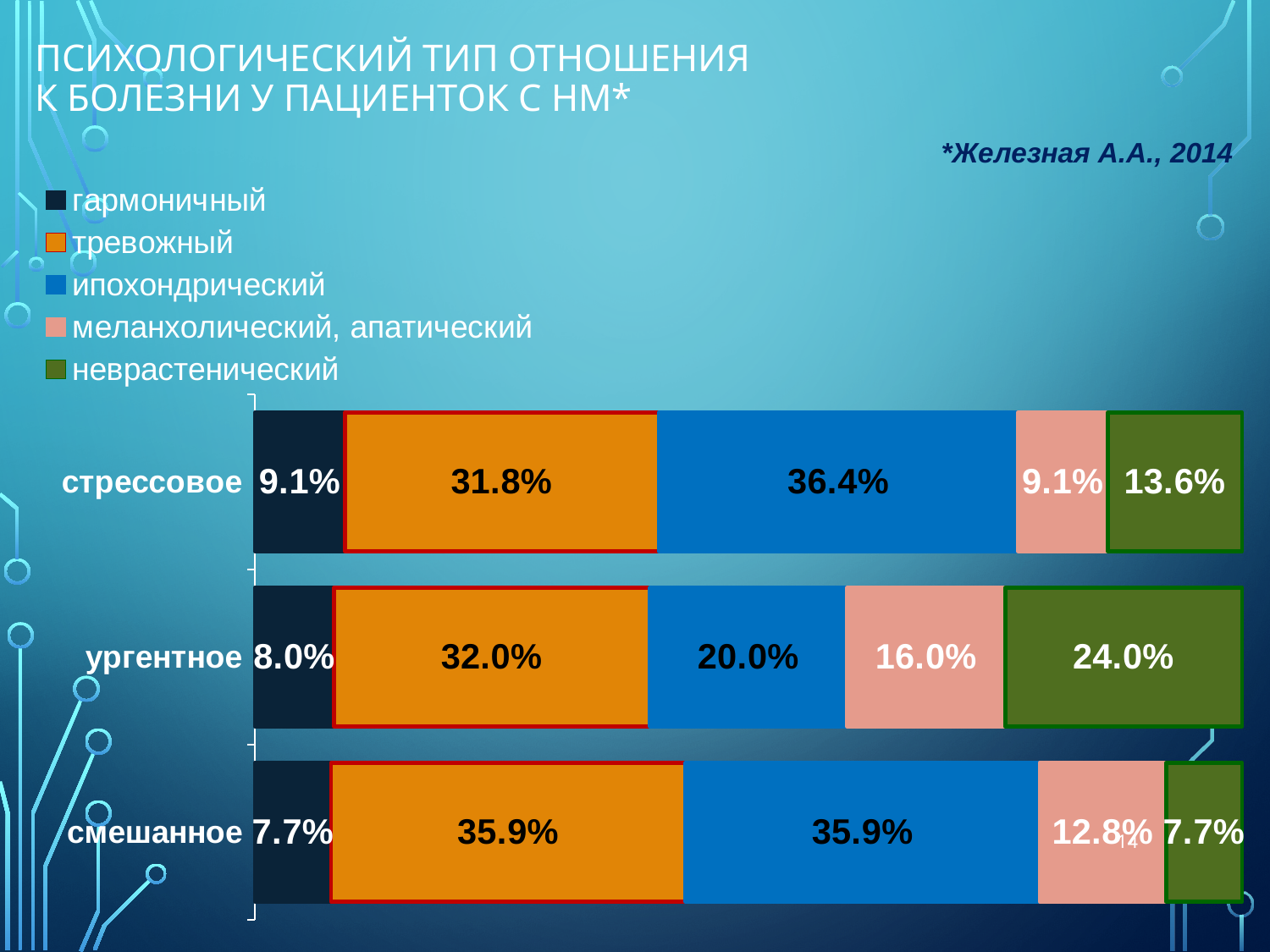
What is the value for меланхолический, апатический in the ургентное bar? 16.0% What is the value for ипохондрический in the стрессовое bar? 36.4% Which category has the highest value for неврастенический? ургентное Which category has the lowest value for ипохондрический? ургентное How many categories are shown on the chart? 3 What is the value for гармоничный in the смешанное bar? 7.7% What is the value for тревожный in the смешанное bar? 35.9% How many series does the legend list? 5 Which is larger: the тревожный value for ургентное or the тревожный value for смешанное? смешанное What is the value for неврастенический in the ургентное bar? 24.0% What is the difference between the ипохондрический values for стрессовое and ургентное? 16.4% What kind of chart is shown on the slide? stacked bar chart